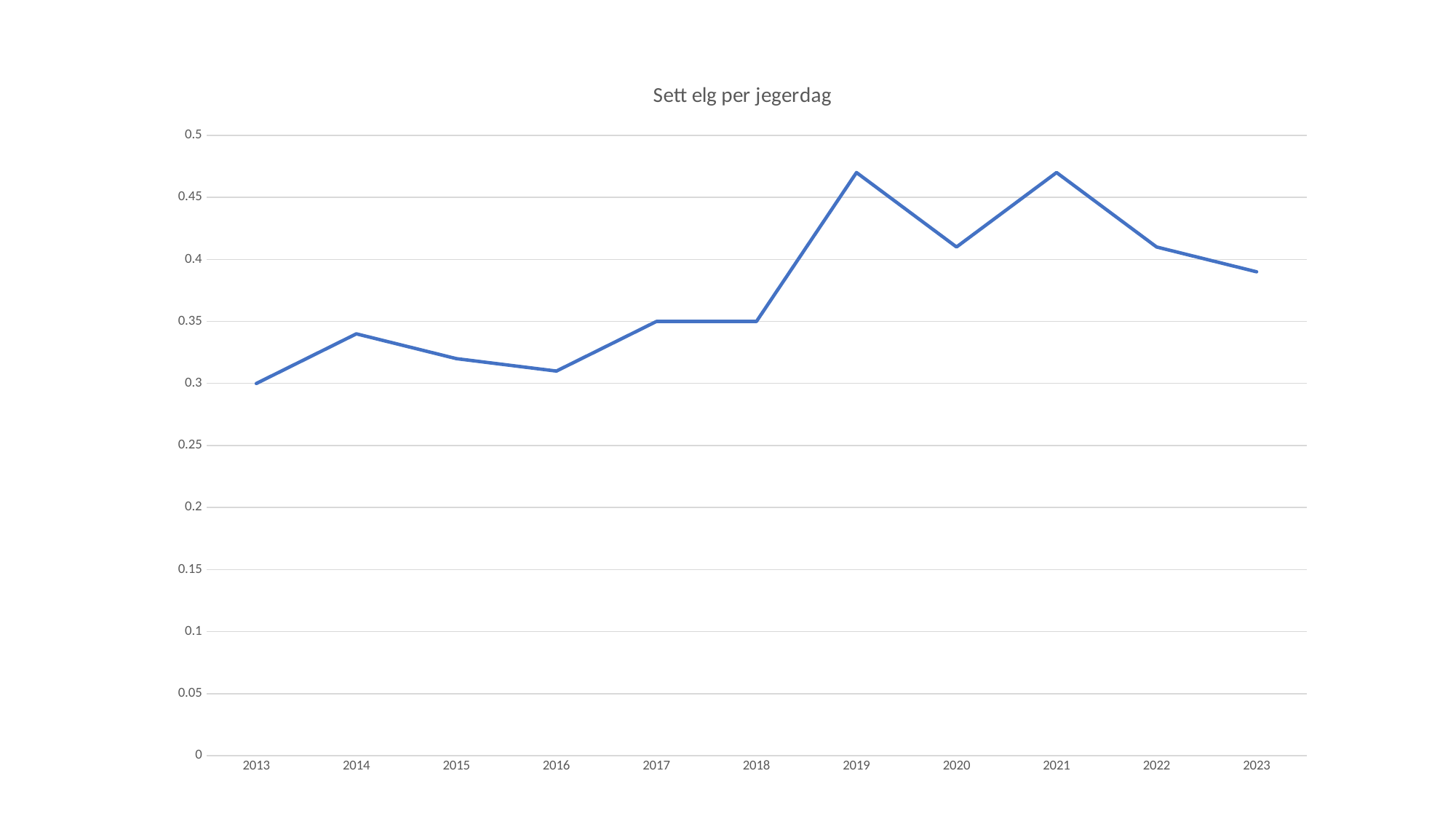
What is the value for 2017? 0.35 What is the title of the chart? Sett elg per jegerdag Is the value for 2019 greater or less than 0.45? greater Is the value for 2023 greater or less than 0.4? less Which is larger, the value for 2020 or the value for 2016? 2020 Do the values rise or fall from 2021 to 2023? fall Is the value for 2020 greater or less than 0.45? less Which is larger, the value for 2019 or the value for 2013? 2019 What is the value for 2013? 0.3 What kind of chart is shown on the slide? line chart How many years are plotted along the x axis? 11